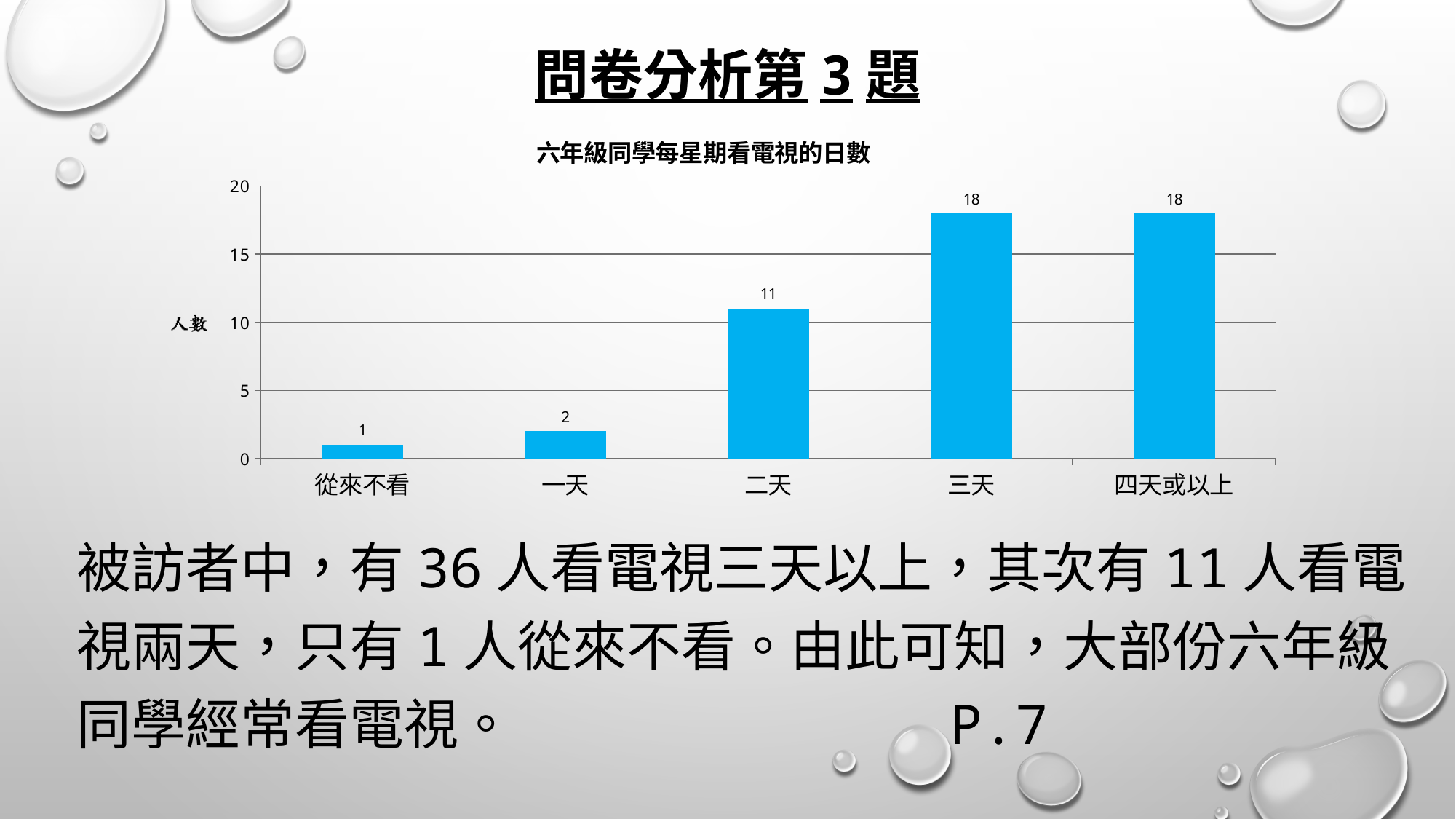
What is the value for 從來不看? 1 What is the value for 三天? 18 What is the value for 二天? 11 What is the title of the chart? 六年級同學每星期看電視的日數 Is the value for 四天或以上 greater or less than 15? greater What is the difference between the values for 三天 and 二天? 7 What kind of chart is shown? bar chart How many categories are shown on the x axis? 5 What is the difference between the values for 二天 and 一天? 9 Which is larger, the value for 二天 or the value for 一天? 二天 Which category has the lowest value? 從來不看 What is the value for 一天? 2